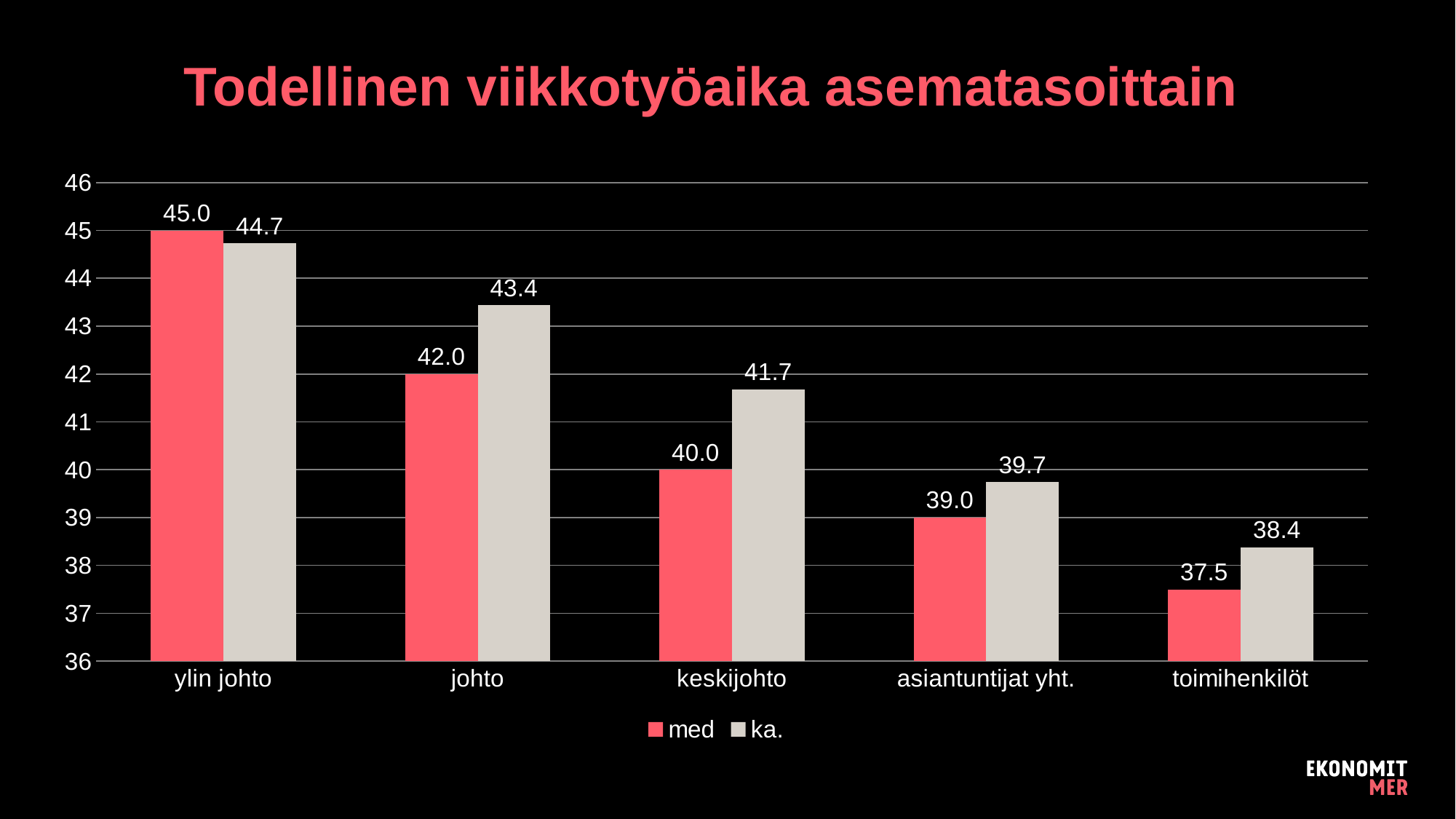
What kind of chart is shown on the slide? bar chart What is the ka. value for johto? 43.4 How many categories are shown on the x axis? 5 Which category has the highest ka. value? ylin johto What is the ka. value for toimihenkilöt? 38.4 How many series does the legend list? 2 What is the med value for ylin johto? 45.0 Do the med values rise or fall from ylin johto to toimihenkilöt? fall Which is larger for keskijohto, the med value or the ka. value? ka. Which category has the lowest med value? toimihenkilöt What is the difference between the ka. and med values for johto? 1.4 What is the med value for asiantuntijat yht.? 39.0